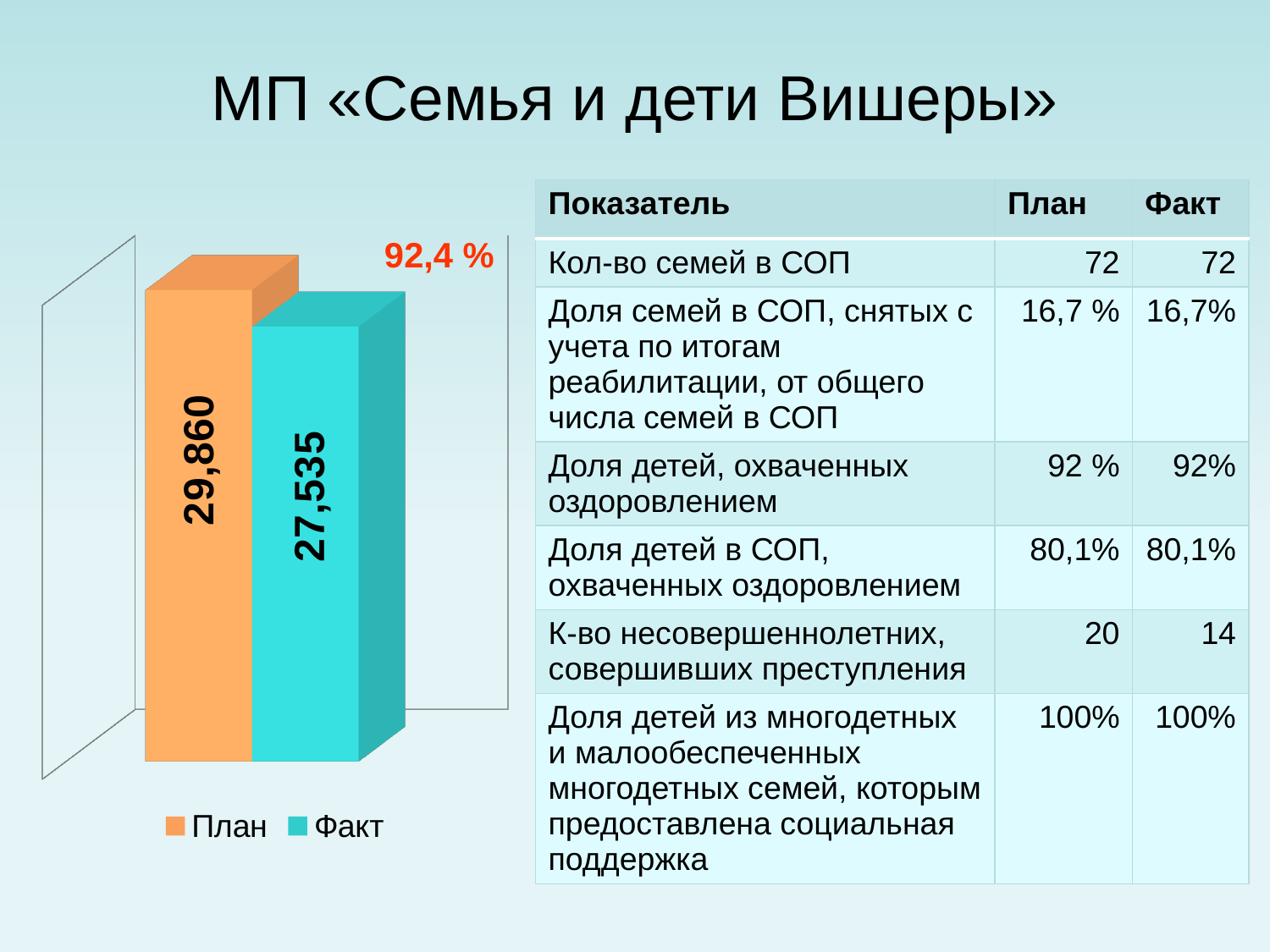
What is the difference between the План and Факт values in the chart? 2,325 What colour is the Факт bar in the chart? Turquoise What percentage is printed in red above the bars in the chart? 92,4 % What is the value of the План bar in the chart? 29,860 Which series has the lowest value in the chart? Факт How many bars are plotted in the chart? 2 Which series has the highest value in the chart? План What is the value of the Факт bar in the chart? 27,535 What kind of chart is shown on the slide? Bar chart Which bar in the chart is higher, План or Факт? План How many series does the chart legend list? 2